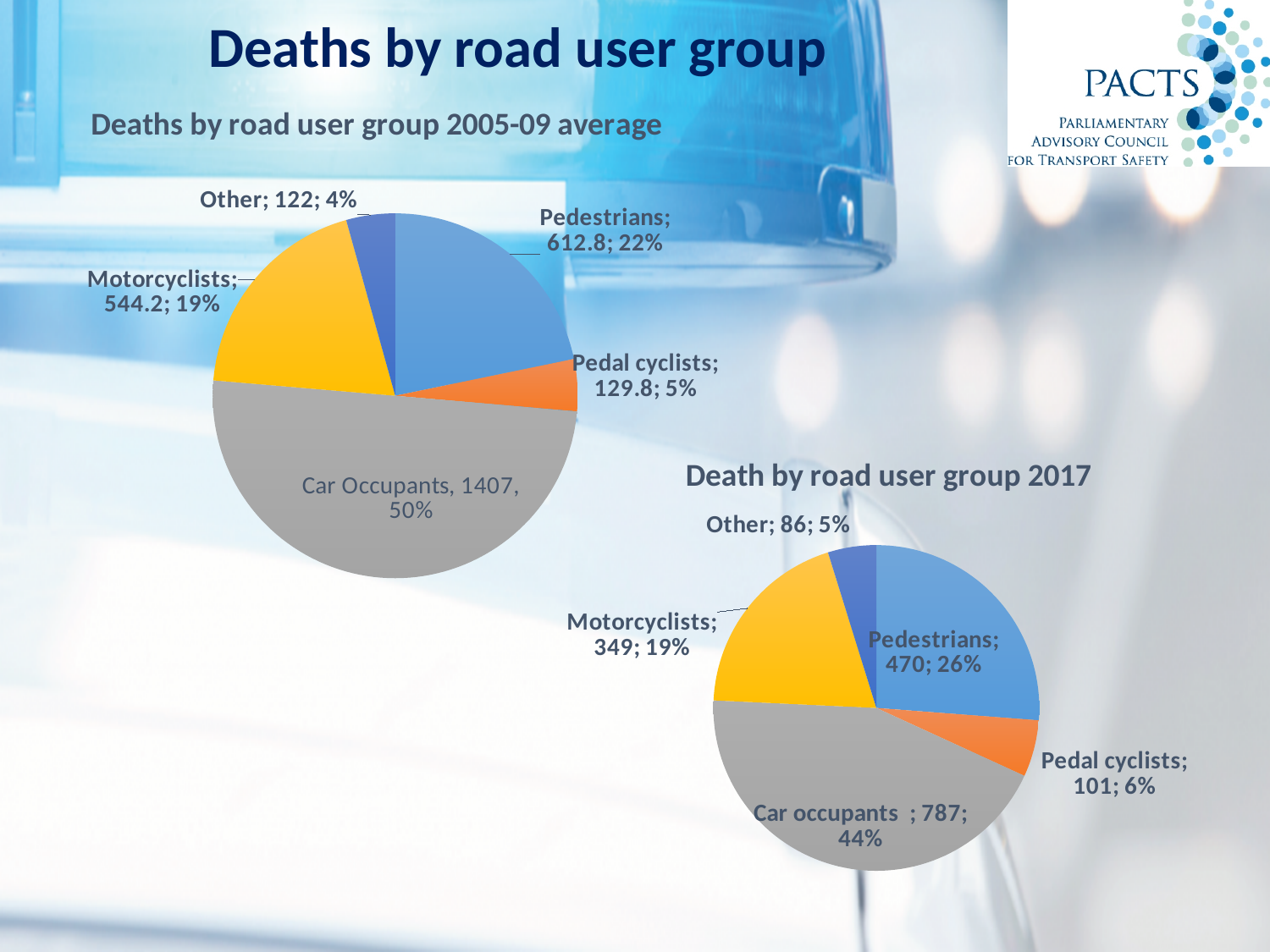
In the 'Deaths by road user group 2005-09 average' chart, what share of the pie do Car Occupants have? 50% In the 'Death by road user group 2017' chart, what is the difference between the Pedestrians value and the Motorcyclists value? 121 In the 'Death by road user group 2017' chart, which category has the highest value? Car occupants What kind of chart is the 'Deaths by road user group 2005-09 average' chart? Pie chart What is the title of the lower-right chart on the slide? Death by road user group 2017 In the 'Death by road user group 2017' chart, what share of the pie do Pedestrians have? 26% In the 'Deaths by road user group 2005-09 average' chart, what is the value for Pedestrians? 612.8 In the 'Deaths by road user group 2005-09 average' chart, which category has the lowest value? Other In the 'Deaths by road user group 2005-09 average' chart, what is the difference between the Motorcyclists value and the Pedal cyclists value? 414.4 How many categories are shown in the 'Death by road user group 2017' chart? 5 In the 'Death by road user group 2017' chart, what is the value for Motorcyclists? 349 In the 'Death by road user group 2017' chart, which is larger: the value for Pedal cyclists or the value for Other? Pedal cyclists